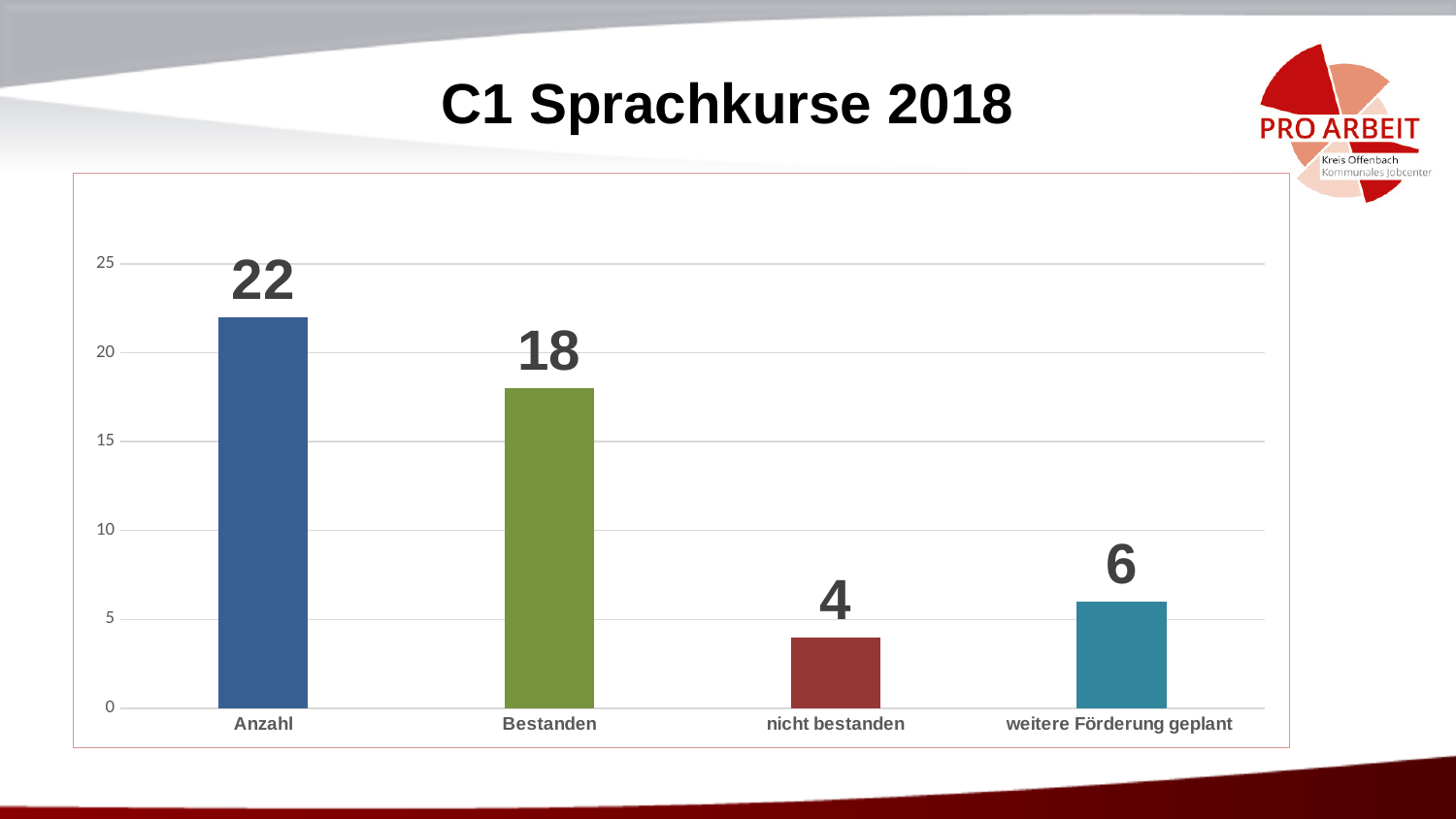
How many categories are shown on the x axis? 4 What is the value for nicht bestanden? 4 What is the value for Bestanden? 18 Which is larger, the value for weitere Förderung geplant or the value for nicht bestanden? weitere Förderung geplant Which category has the highest value? Anzahl What is the title of the slide containing the chart? C1 Sprachkurse 2018 What is the value for Anzahl? 22 What is the value for weitere Förderung geplant? 6 Which category has the lowest value? nicht bestanden Is the value for Bestanden greater or less than 15? greater What kind of chart is shown on the slide? bar chart What is the difference between the values for Anzahl and Bestanden? 4